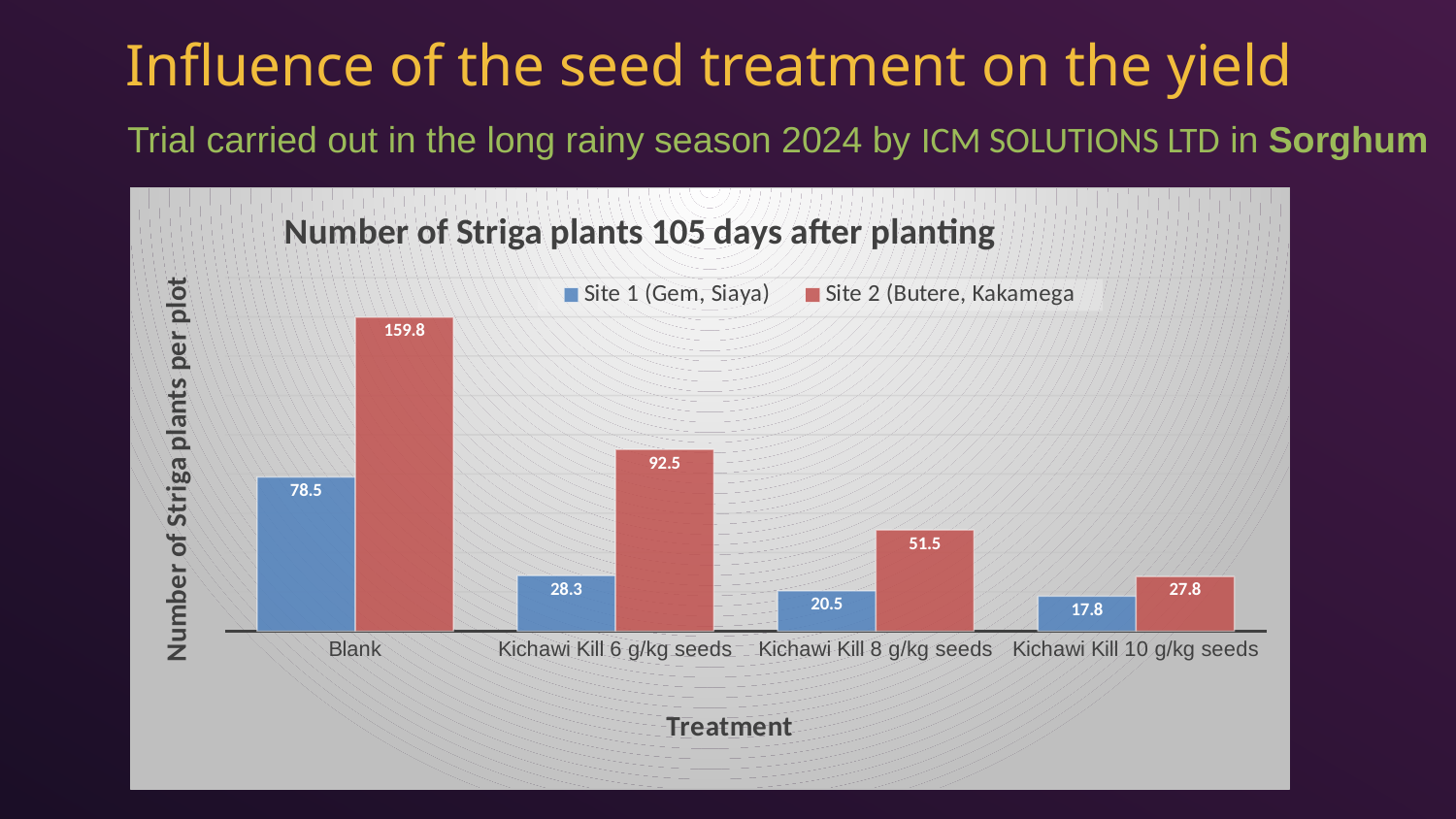
Which treatment has the lowest value for Site 1 (Gem, Siaya)? Kichawi Kill 10 g/kg seeds What is the difference between Site 2 and Site 1 for the Blank treatment? 81.3 How many series does the legend list? 2 What is the difference between Site 2 and Site 1 for Kichawi Kill 6 g/kg seeds? 64.2 Which is larger: Site 2 for Kichawi Kill 10 g/kg seeds or Site 1 for Kichawi Kill 6 g/kg seeds? Site 1 for Kichawi Kill 6 g/kg seeds What is the value for Site 1 (Gem, Siaya) for the Blank treatment? 78.5 What kind of chart is shown on the slide? Bar chart How many treatment categories are shown on the x axis? 4 What is the value for Site 1 (Gem, Siaya) for Kichawi Kill 10 g/kg seeds? 17.8 What is the value for Site 2 (Butere, Kakamega) for Kichawi Kill 8 g/kg seeds? 51.5 Do the Site 2 (Butere, Kakamega) values rise or fall from Blank to Kichawi Kill 10 g/kg seeds? Fall Which treatment has the highest value for Site 2 (Butere, Kakamega)? Blank